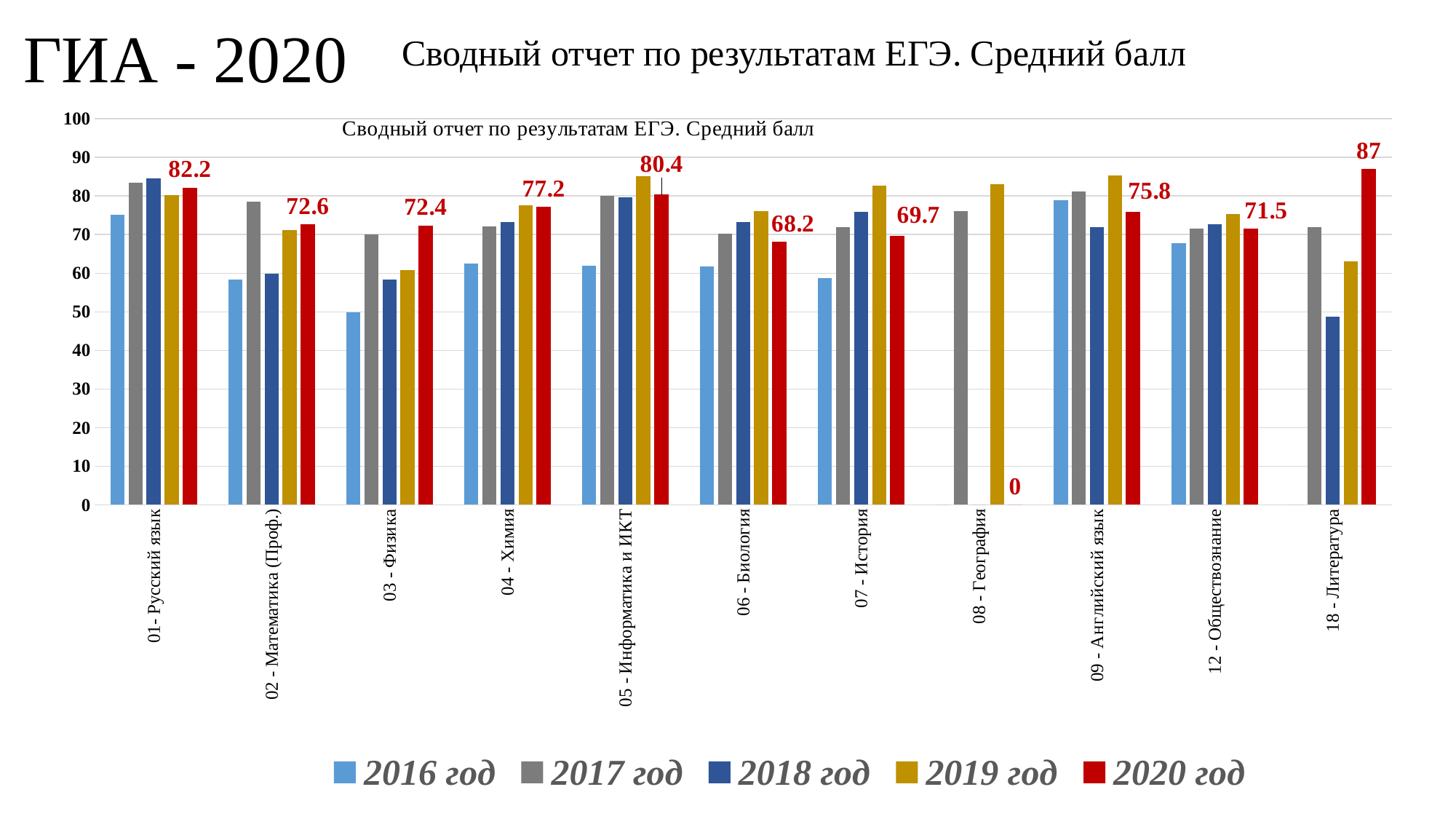
How many series does the legend list? 5 What is the 2020 год value for 05 - Информатика и ИКТ? 80.4 Which category has the highest 2020 год value? 18 - Литература Is the 2019 год value for 09 - Английский язык greater or less than 80? greater How many subject categories are shown on the x axis? 11 Which category has the lowest 2020 год value? 08 - География What is the 2020 год value for 08 - География? 0 What is the 2020 год value for 01 - Русский язык? 82.2 Is the 2016 год value for 03 - Физика greater or less than 60? less What is the 2020 год value for 18 - Литература? 87 What is the difference between the 2020 год values for 18 - Литература and 01 - Русский язык? 4.8 Which has the larger 2020 год value: 04 - Химия or 06 - Биология? 04 - Химия